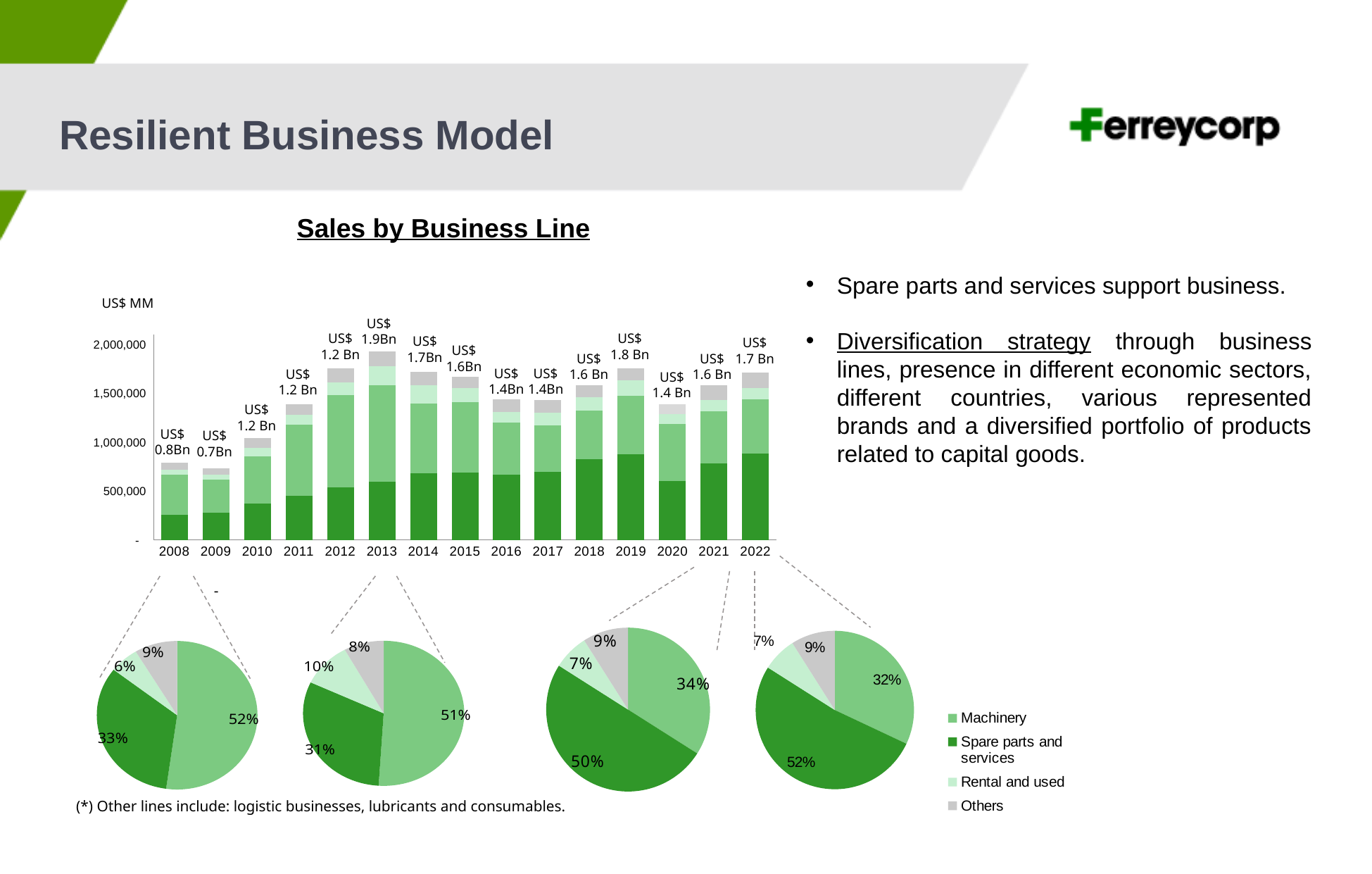
In the Sales by Business Line bar chart, is the total bar for 2022 greater or less than 1,500,000? greater In the leftmost pie chart, what share does Machinery have? 52% In the rightmost pie chart, what share does Spare parts and services have? 52% In the Sales by Business Line bar chart, what total sales value is labelled for 2013? US$ 1.9Bn What kind of chart is the Sales by Business Line chart at the top of the slide? Bar chart In the Sales by Business Line bar chart, which year has the lowest total sales? 2009 In the Sales by Business Line bar chart, what is the difference between the labelled totals for 2013 and 2009? US$ 1.2 Bn How many series does the legend list for the business line charts? 4 In the Sales by Business Line bar chart, what total sales value is labelled for 2019? US$ 1.8 Bn In the second pie chart from the left, what share does Rental and used have? 10% How many years are shown on the x axis of the Sales by Business Line bar chart? 15 In the Sales by Business Line bar chart, which year has the highest total sales? 2013